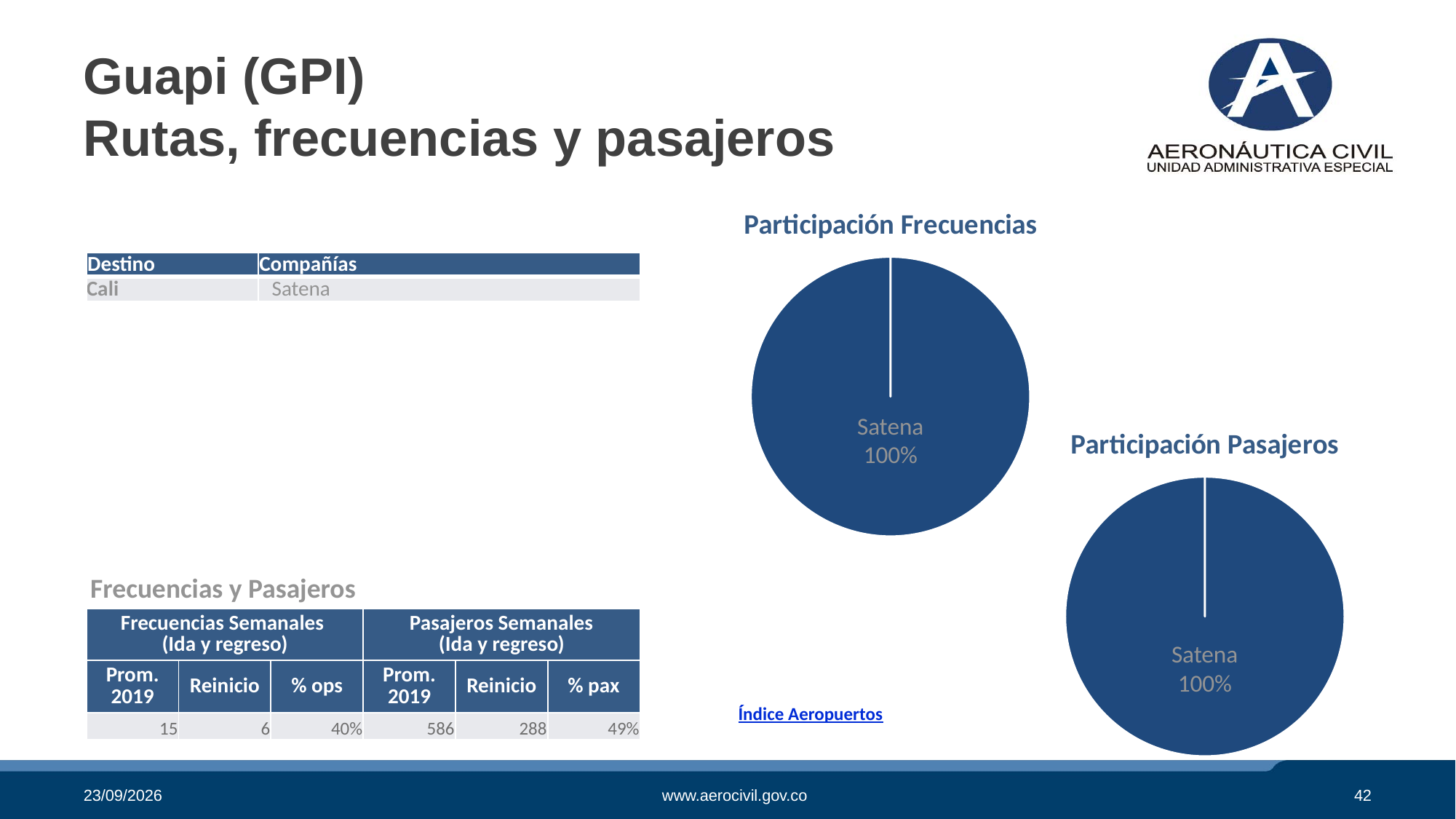
What is the title of the pie chart on the lower right of the slide? Participación Pasajeros Which company is shown in the 'Participación Pasajeros' chart? Satena Which company is shown in the 'Participación Frecuencias' chart? Satena What kind of chart is 'Participación Frecuencias'? Pie chart How many slices does the 'Participación Pasajeros' pie chart have? 1 How many pie charts are on the slide? 2 What is the title of the pie chart on the upper right of the slide? Participación Frecuencias How many slices does the 'Participación Frecuencias' pie chart have? 1 What kind of chart is 'Participación Pasajeros'? Pie chart In the 'Participación Pasajeros' chart, what share does Satena have? 100% In the 'Participación Frecuencias' chart, what share does Satena have? 100%